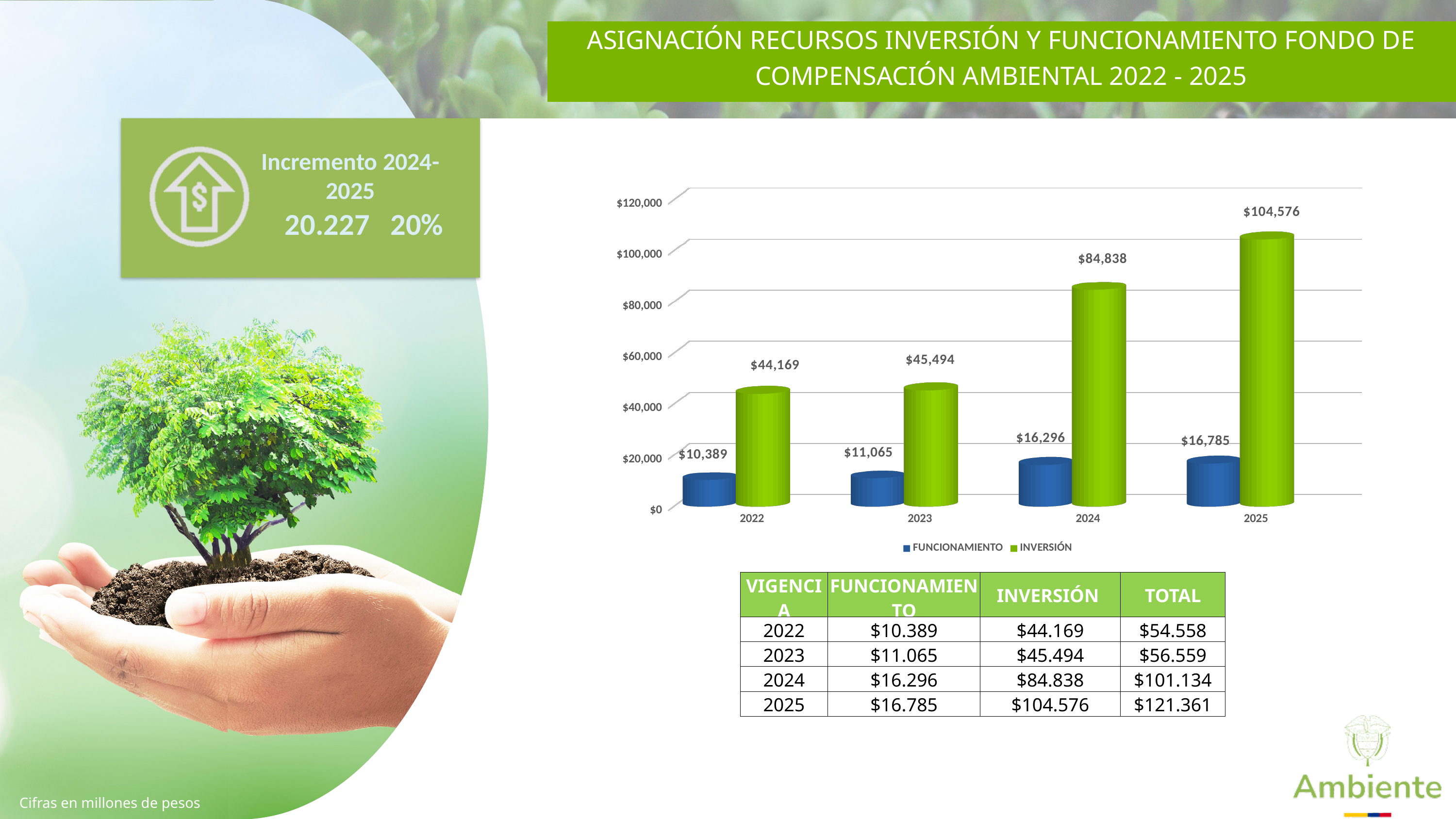
Which year has the highest INVERSIÓN value? 2025 What is the value of INVERSIÓN for 2023? $45,494 Which is larger in 2024: FUNCIONAMIENTO or INVERSIÓN? INVERSIÓN What kind of chart is shown on the slide? Bar chart What is the value of INVERSIÓN for 2025? $104,576 How many years are shown on the x axis of the chart? 4 What is the difference between the FUNCIONAMIENTO values for 2025 and 2024? $489 What is the difference between the INVERSIÓN values for 2025 and 2024? $19,738 How many series does the chart legend list? 2 What is the value of FUNCIONAMIENTO for 2022? $10,389 What is the value of FUNCIONAMIENTO for 2024? $16,296 Which year has the lowest FUNCIONAMIENTO value? 2022